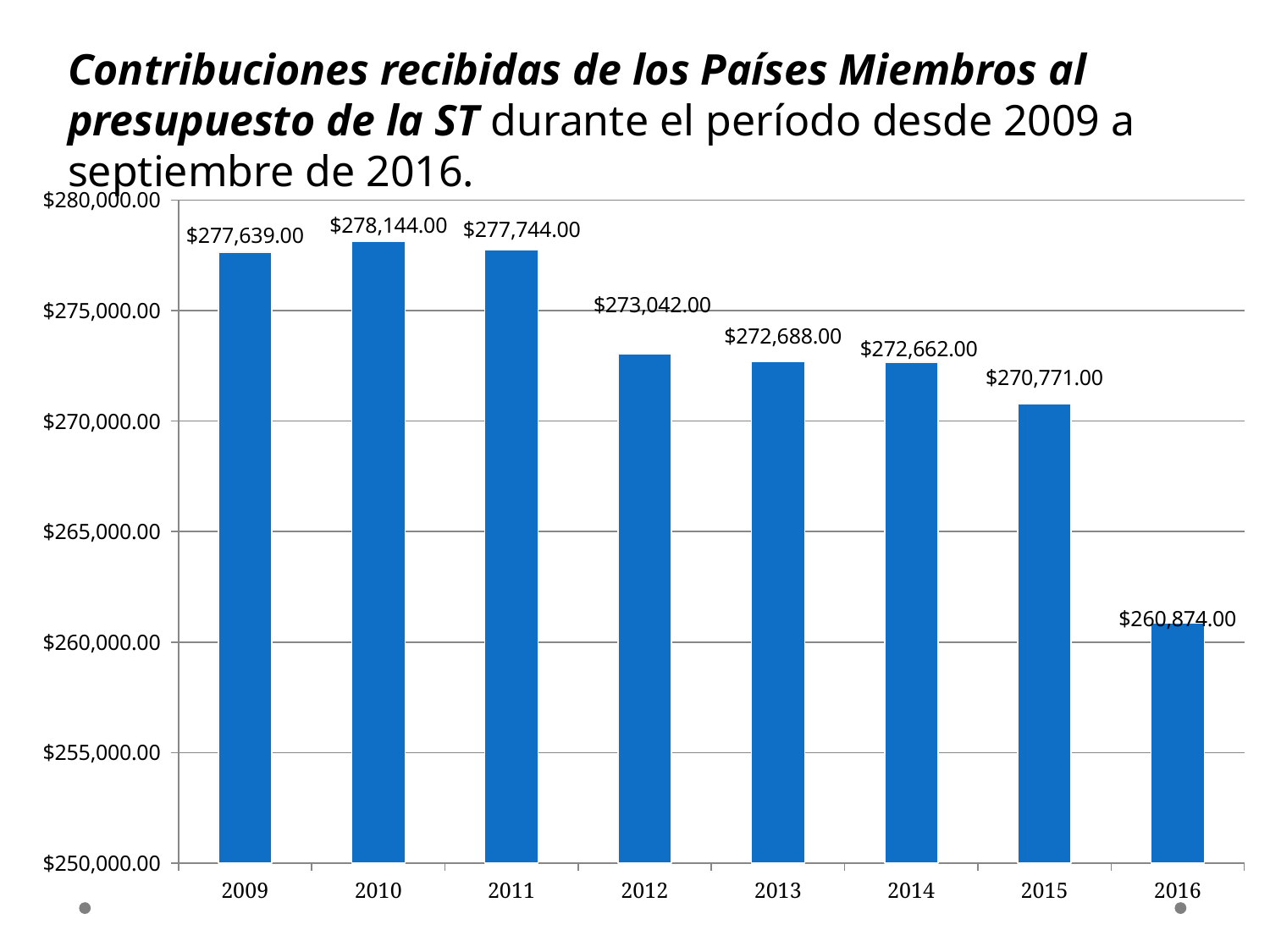
What is the value for 2013? $272,688.00 Is the value for 2014 greater or less than $270,000.00? greater What is the difference between the values for 2015 and 2016? $9,897.00 Which is larger, the value for 2012 or the value for 2015? 2012 Do the values generally rise or fall from 2011 to 2016? fall What kind of chart is shown on the slide? bar chart What is the difference between the values for 2010 and 2011? $400.00 How many years are shown on the x axis? 8 Which year has the highest value? 2010 What is the value for 2016? $260,874.00 Which year has the lowest value? 2016 What is the value for 2009? $277,639.00